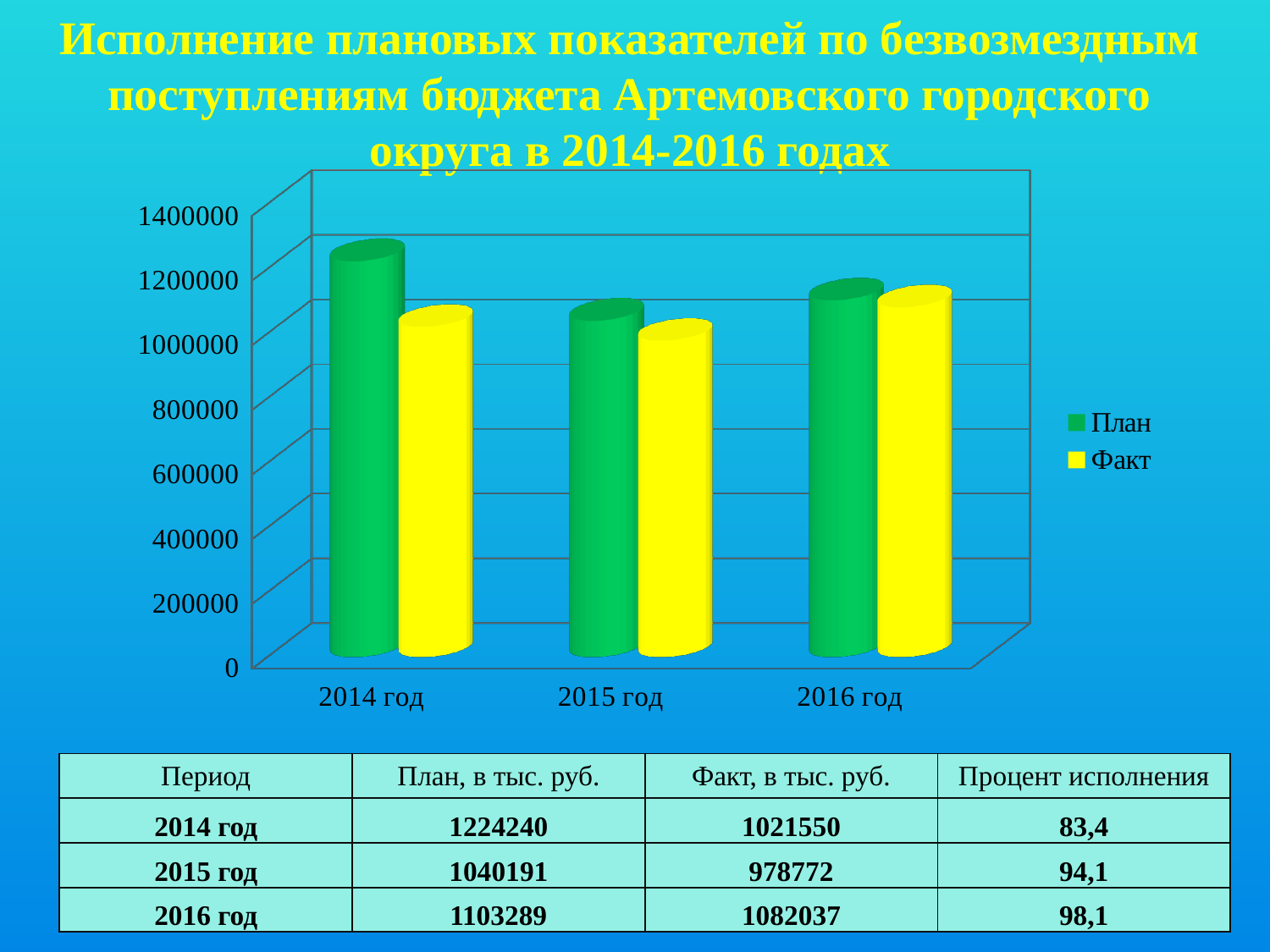
What is the План value for 2014 год, in thousand rubles? 1224240 In which year is the Факт value lowest? 2015 год In which year is the План value highest? 2014 год How many years (categories) are shown on the x axis of the chart? 3 Is the Факт value for 2016 год greater or less than 1000000? greater What is the difference between План and Факт for 2014 год, in thousand rubles? 202690 What is the Факт value for 2015 год, in thousand rubles? 978772 What is the Процент исполнения for 2016 год? 98,1 How many series does the chart legend list? 2 Which is larger for 2014 год, План or Факт? План Which colour represents the Факт series in the chart? yellow What kind of chart is shown on the slide? bar chart